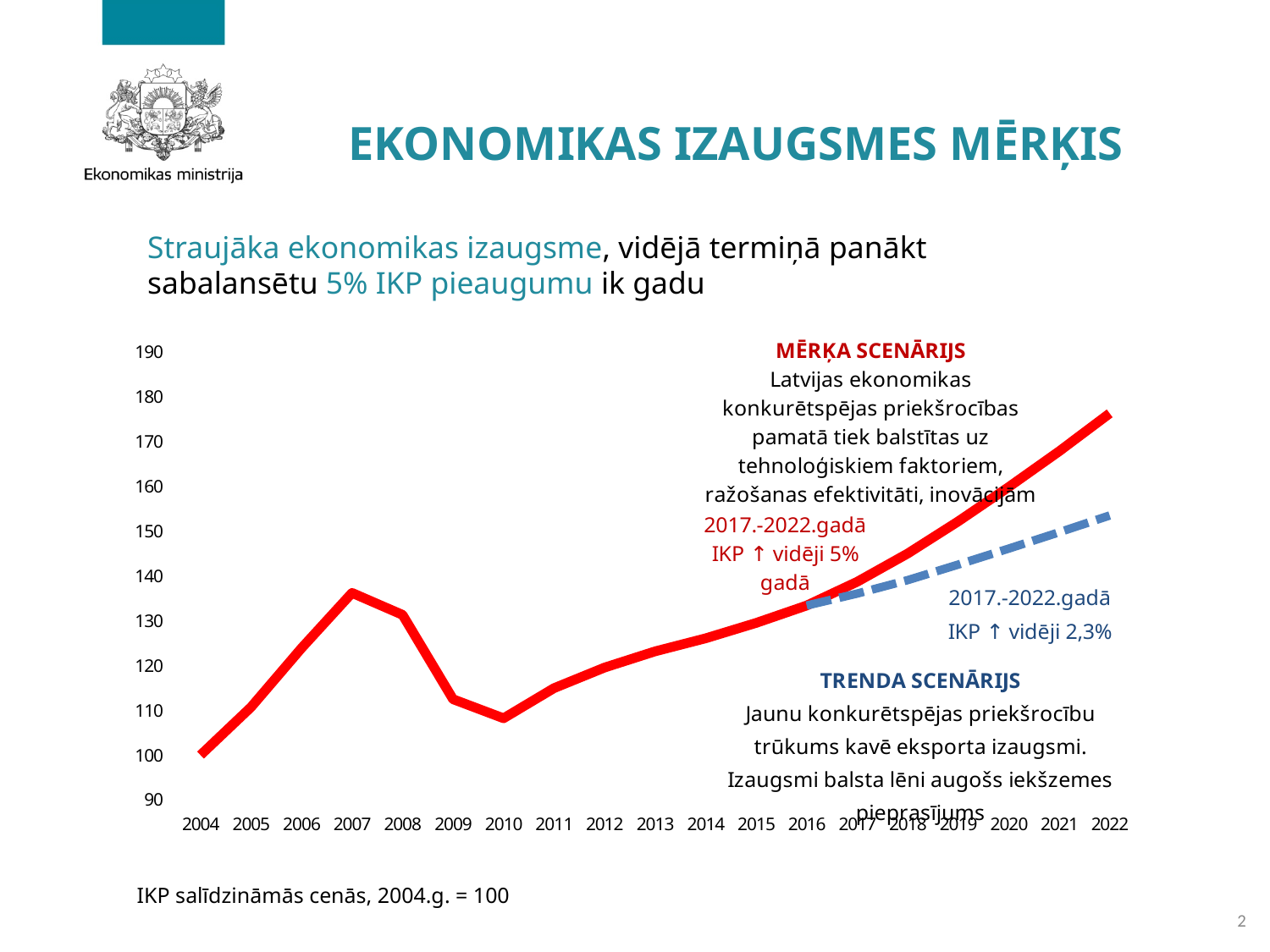
Which is larger, the value for 2007 or the value for 2010? 2007 Is the value of the red solid line for 2022 greater or less than 170? greater Which scenario does the blue dashed line represent? TRENDA SCENĀRIJS How many years are labelled on the x axis of the chart? 19 Is the value for 2007 greater or less than 130? greater Which year has the highest value on the red solid line? 2022 Is the value for 2010 greater or less than 120? less Which year has the lowest value on the chart? 2004 What is the index value for 2004 according to the chart's footnote? 100 Does the red solid line rise or fall between 2010 and 2022? rise What kind of chart is shown on the slide? line chart